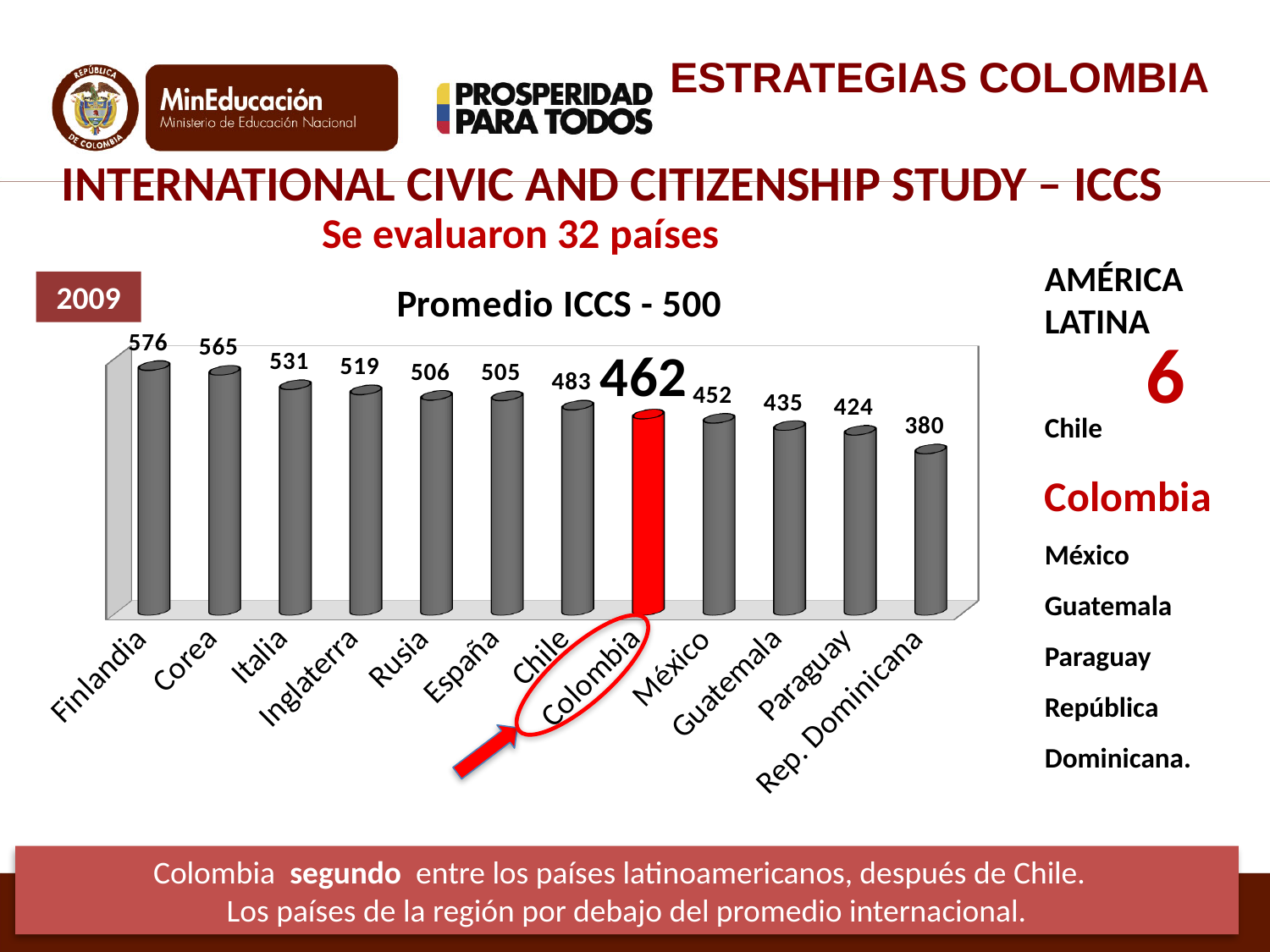
Which country has the highest value? Finlandia What is the value for Finlandia? 576 Which has a larger value, Corea or Italia? Corea What is the difference between the values for Chile and Colombia? 21 Which country's bar is coloured red? Colombia What is the value for Colombia? 462 What is the value for Rep. Dominicana? 380 Do the values rise or fall from left to right along the x axis? Fall What kind of chart is shown? Bar chart How many countries are shown in the chart? 12 What is the title of the chart? Promedio ICCS - 500 Which country has the lowest value? Rep. Dominicana